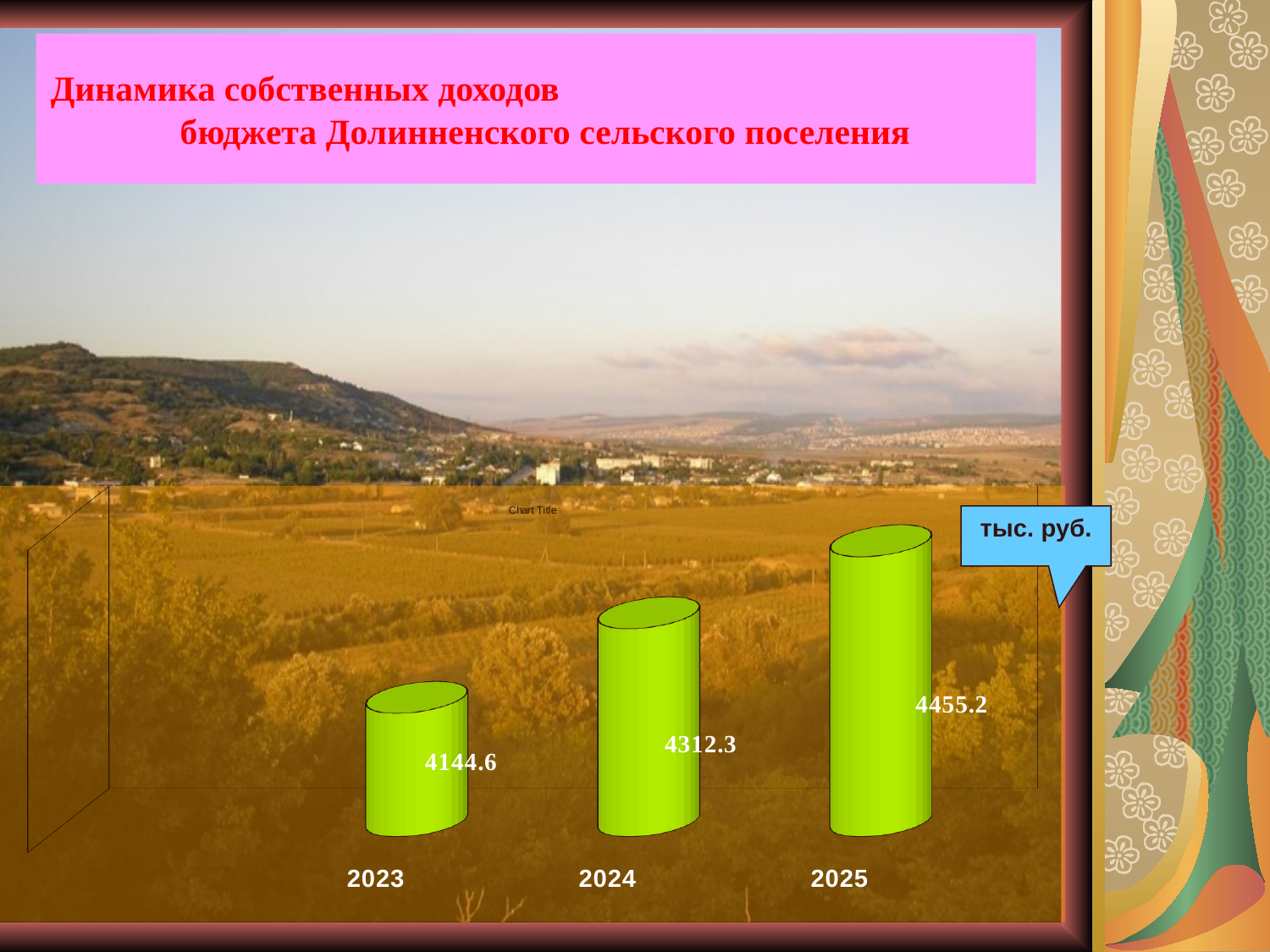
Which is larger, the value for 2024 or the value for 2025? 2025 What is the difference between the values for 2024 and 2023? 167.7 What is the value for 2024? 4312.3 What is the difference between the values for 2025 and 2023? 310.6 What is the value for 2025? 4455.2 Which year has the highest value? 2025 What kind of chart is shown on the slide? bar chart Do the values rise or fall from 2023 to 2025? rise Which year has the lowest value? 2023 What unit is indicated in the callout next to the chart? тыс. руб. How many years are shown on the chart? 3 What is the value for 2023? 4144.6